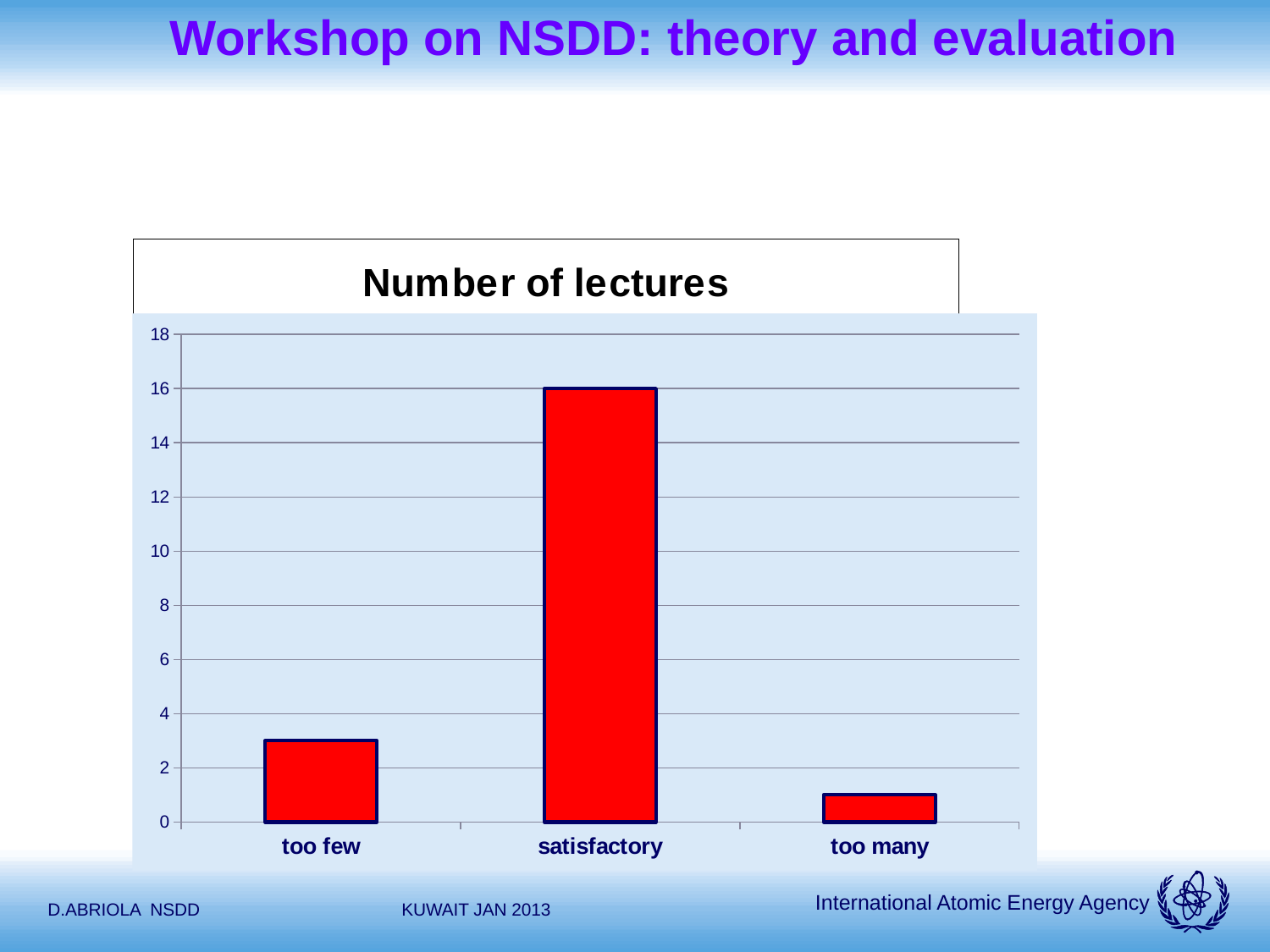
What is the value for 'satisfactory' in the chart? 16 Which is larger, the value for 'too few' or the value for 'too many'? too few What kind of chart is shown on the slide? bar chart Which category has the highest value in the chart? satisfactory Is the value for 'too few' greater or less than 4? less Which category has the lowest value in the chart? too many What colour are the bars in the chart? red How many categories are shown on the x axis of the chart? 3 What is the title of the chart? Number of lectures Is the value for 'satisfactory' greater or less than 10? greater Is the value for 'too many' greater or less than 2? less